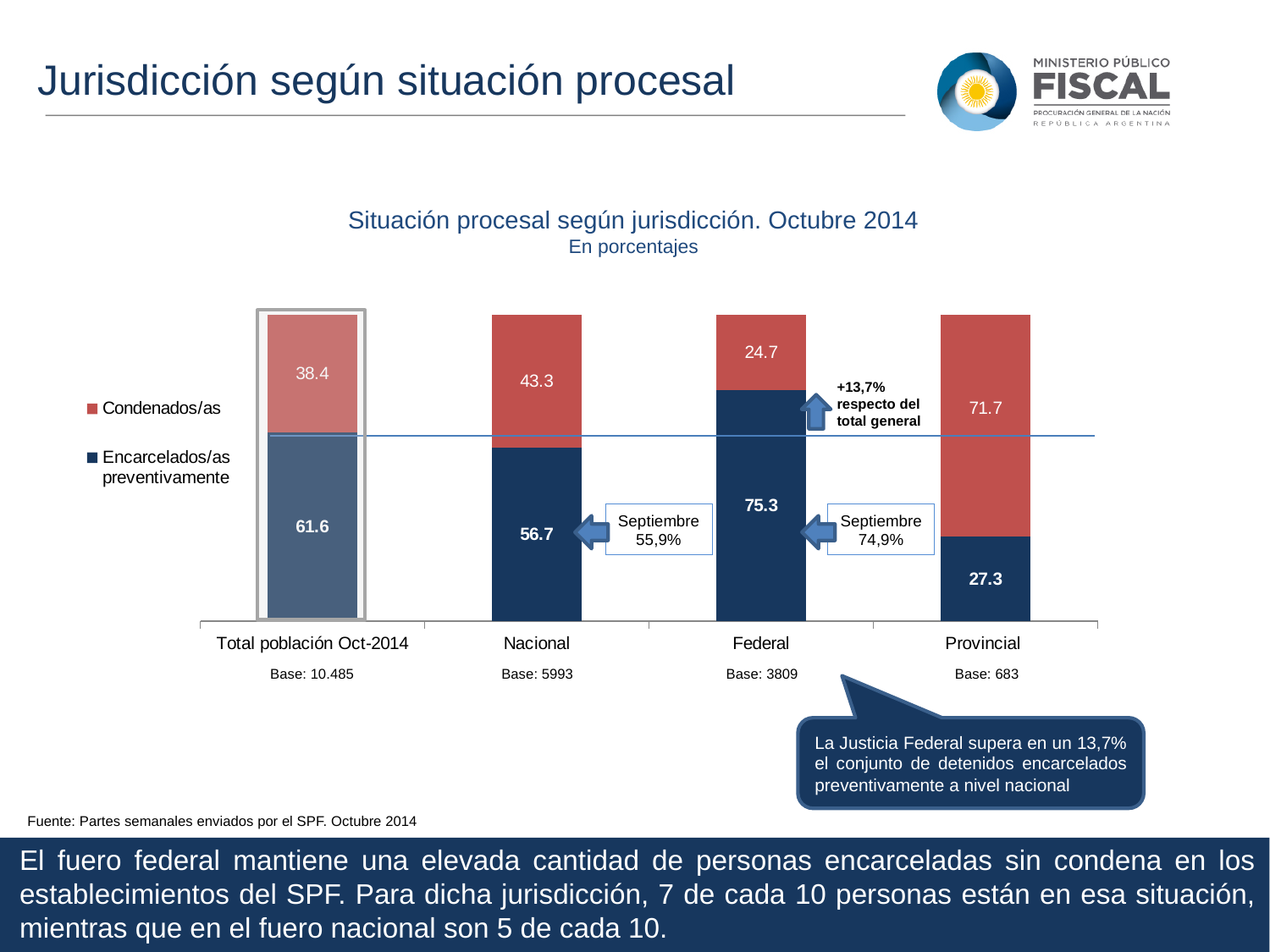
What is the value for Condenados/as in the Provincial category? 71.7 What is the value for Encarcelados/as preventivamente in the Federal category? 75.3 What is the base (number of cases) shown for the Federal category? 3809 Which category has the lowest value for Condenados/as? Federal What is the value for Encarcelados/as preventivamente in the Nacional category? 56.7 What is the value for Condenados/as in the Total población Oct-2014 category? 38.4 How many series does the legend list? 2 Which is larger: the Condenados/as value for Provincial or for Nacional? Provincial What is the difference between the Encarcelados/as preventivamente values for Federal and Nacional? 18.6 Which category has the highest value for Encarcelados/as preventivamente? Federal What kind of chart is shown on the slide? Stacked bar chart How many categories are shown on the x axis? 4